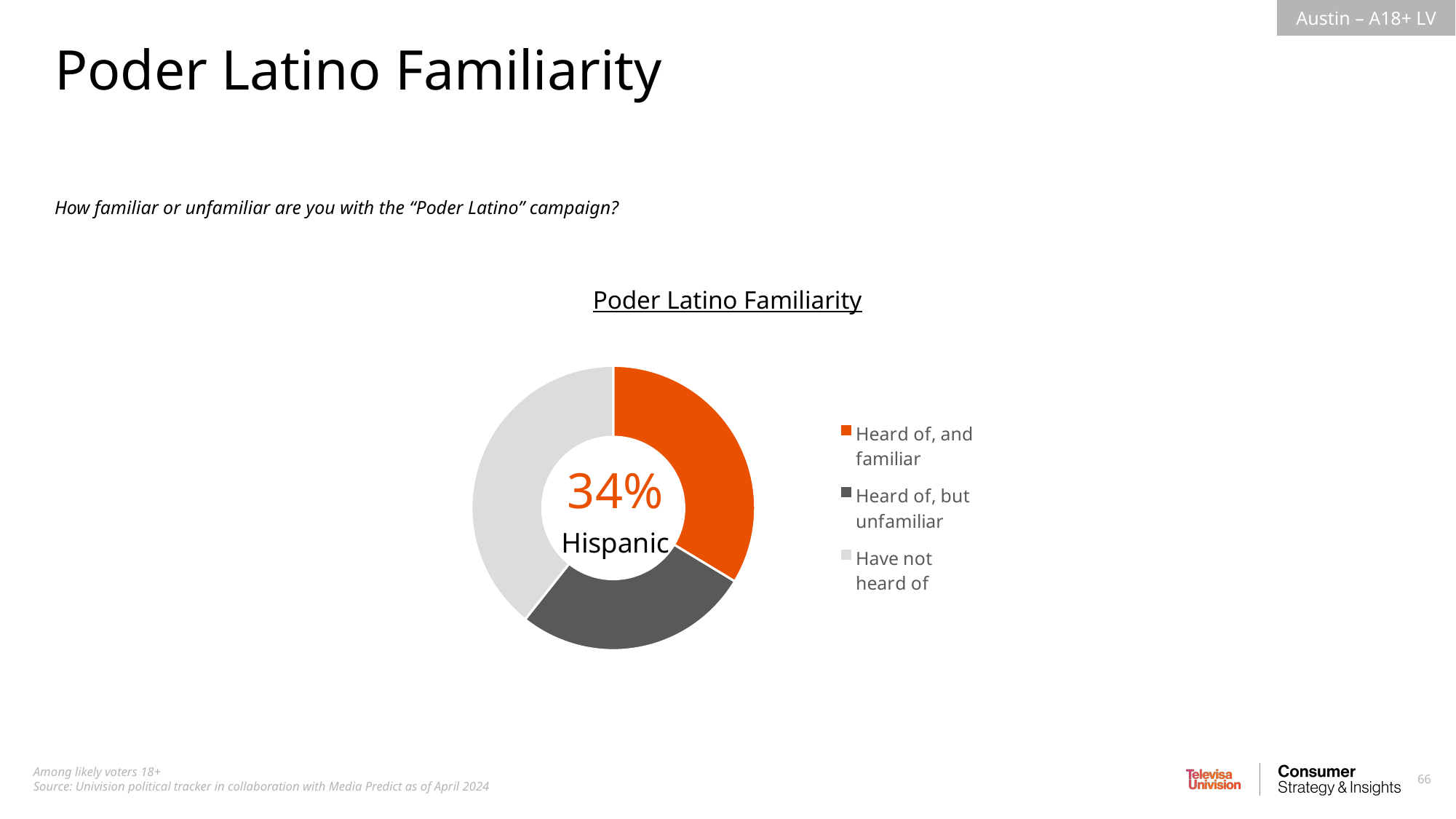
Which category is the smallest slice of the Poder Latino Familiarity chart? Heard of, but unfamiliar What percentage is printed in the centre of the Poder Latino Familiarity chart? 34% How many categories does the legend of the Poder Latino Familiarity chart list? 3 What share of Hispanic likely voters have heard of, and are familiar with, the Poder Latino campaign? 34% Which slice is larger: 'Heard of, and familiar' or 'Heard of, but unfamiliar'? Heard of, and familiar What is the title of the chart on the slide? Poder Latino Familiarity What kind of chart is shown on the slide? donut chart What colour represents 'Heard of, and familiar' in the chart? orange What group label is printed in the centre of the donut chart below the percentage? Hispanic